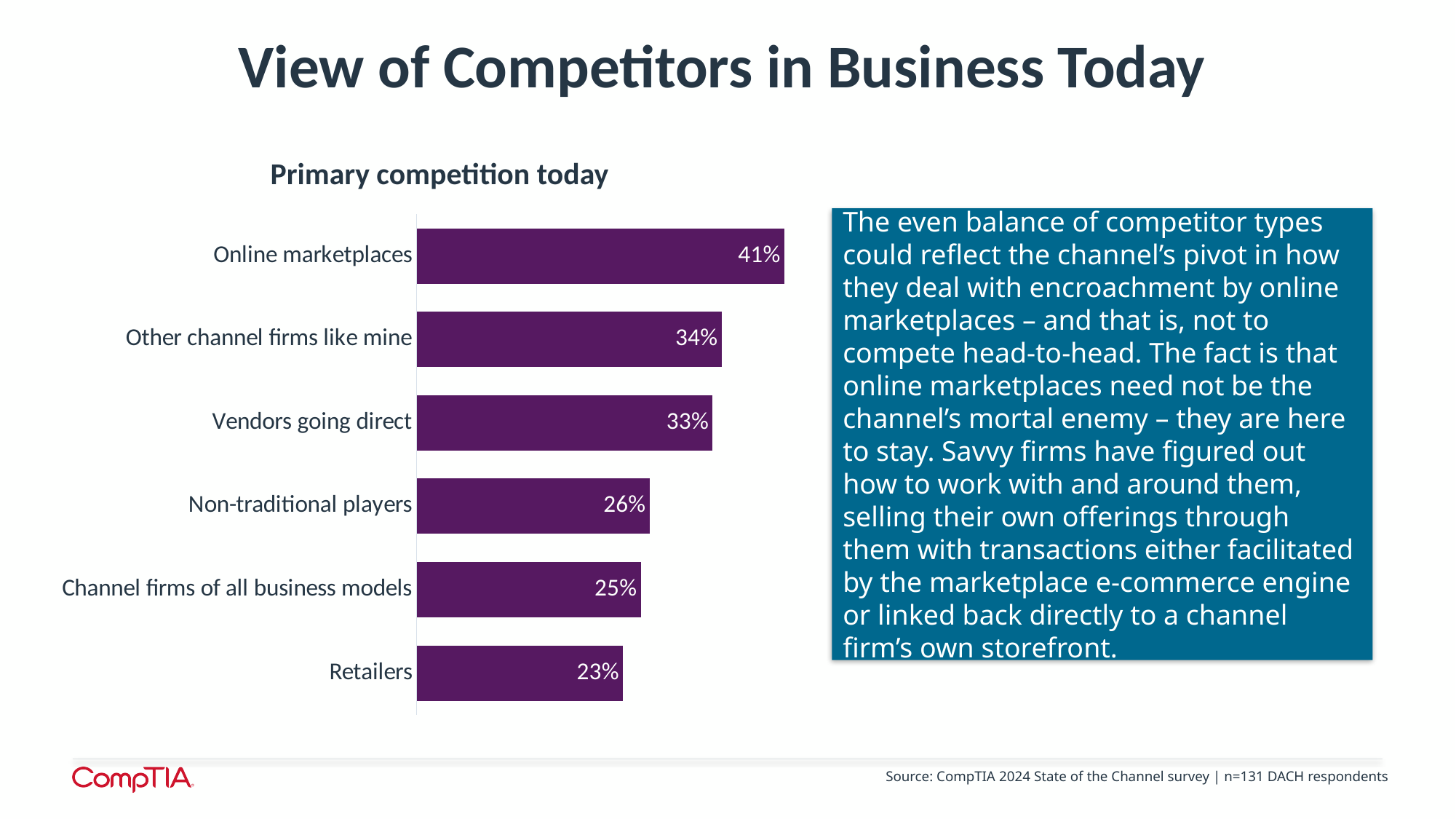
How many categories are shown in the chart? 6 Which category has the highest value? Online marketplaces Which is larger, Other channel firms like mine or Non-traditional players? Other channel firms like mine What kind of chart is shown on the slide? Bar chart What is the value for Vendors going direct? 33% Which category has the lowest value? Retailers What percentage is shown for Retailers? 23% What is the difference between Non-traditional players and Retailers? 3% What is the title of the chart? Primary competition today What is the value for Channel firms of all business models? 25% What percentage is shown for Online marketplaces? 41% What is the difference between Online marketplaces and Other channel firms like mine? 7%